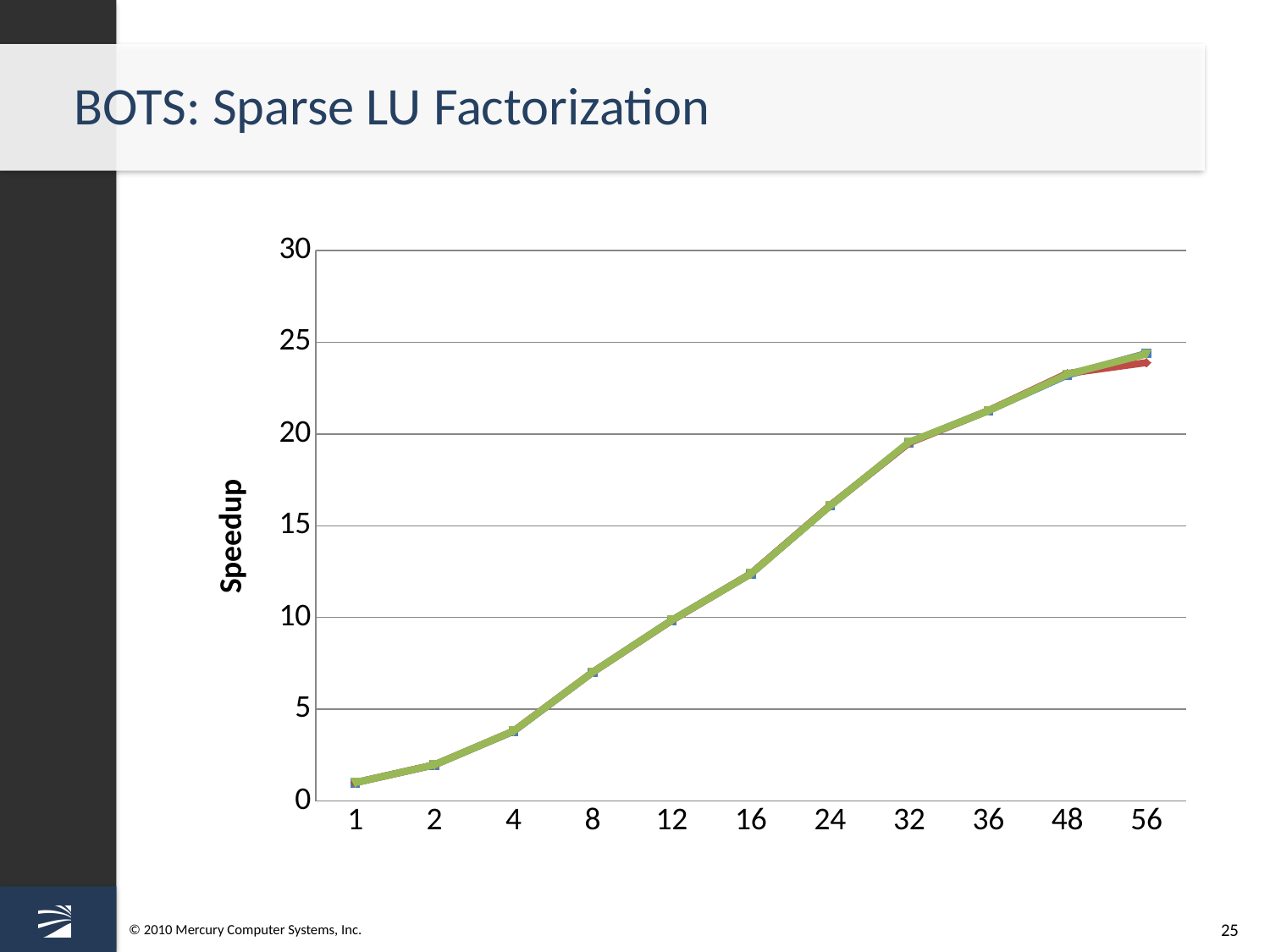
How many x-axis categories (thread counts) are plotted on the chart? 11 At which x-axis value is the speedup lowest? 1 Is the speedup at x = 8 greater or less than 5? greater Is the speedup at x = 36 greater or less than 20? greater Which has the larger speedup, x = 24 or x = 8? 24 Is the speedup at x = 16 greater or less than 15? less What is the label on the vertical axis of the chart? Speedup At which x-axis value is the speedup highest? 56 Do the speedup values rise or fall as the x-axis values increase? rise What kind of chart is shown on the slide? line chart